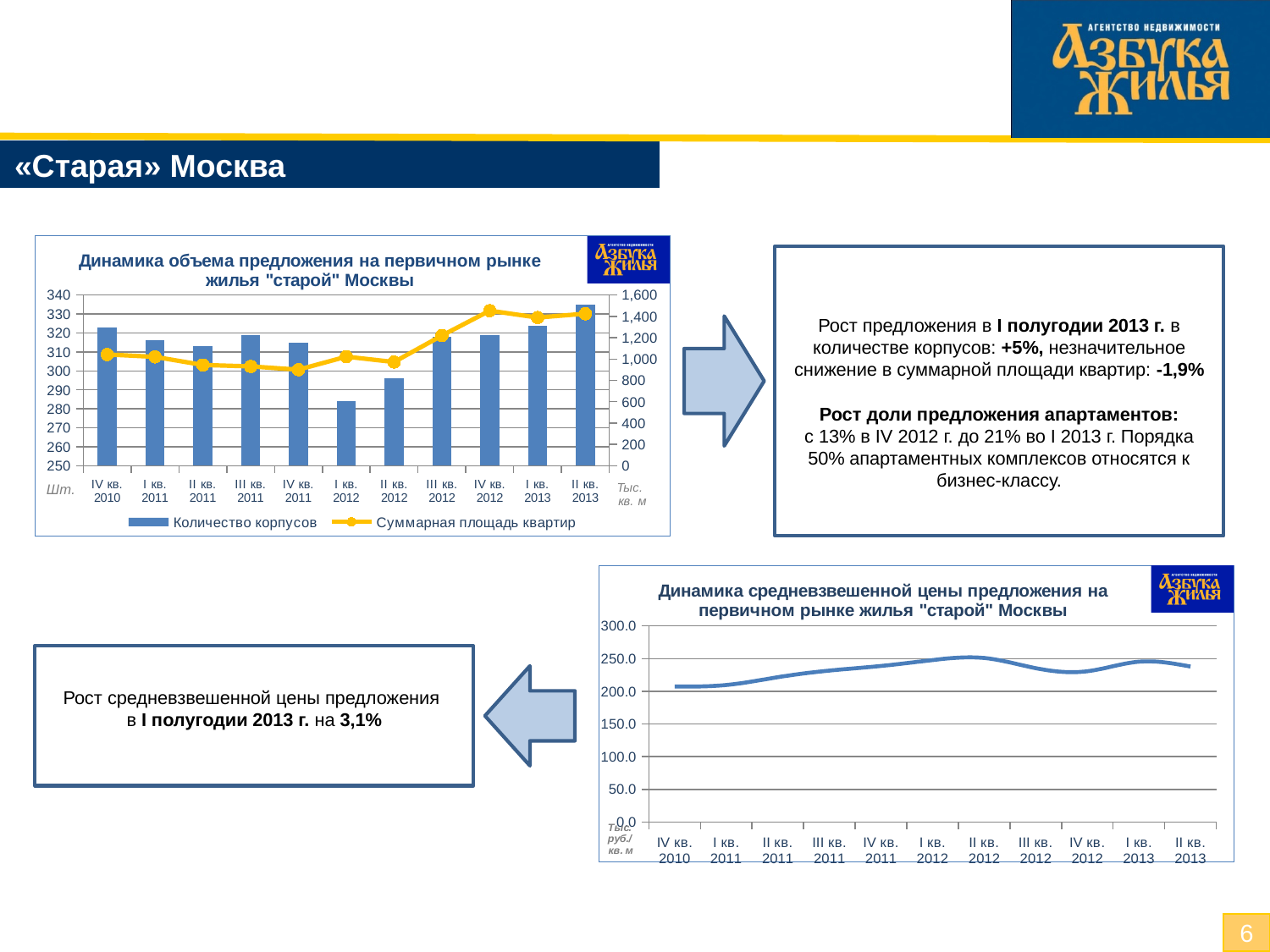
In the bottom-right chart "Динамика средневзвешенной цены предложения на первичном рынке жилья "старой" Москвы", is the value for IV кв. 2010 greater or less than 250.0? less In the bottom-right chart "Динамика средневзвешенной цены предложения на первичном рынке жилья "старой" Москвы", does the value rise or fall from IV кв. 2010 to IV кв. 2012? rise In the bottom-right chart "Динамика средневзвешенной цены предложения на первичном рынке жилья "старой" Москвы", how many quarters are shown on the x axis? 11 In the top-left chart "Динамика объема предложения на первичном рынке жилья "старой" Москвы", which series is drawn as a line with markers? Суммарная площадь квартир In the top-left chart "Динамика объема предложения на первичном рынке жилья "старой" Москвы", which quarter has the highest bar for Количество корпусов? II кв. 2013 In the top-left chart "Динамика объема предложения на первичном рынке жилья "старой" Москвы", is the Количество корпусов value for I кв. 2012 greater or less than 290? less In the top-left chart "Динамика объема предложения на первичном рынке жилья "старой" Москвы", how many quarters are shown on the x axis? 11 In the top-left chart "Динамика объема предложения на первичном рынке жилья "старой" Москвы", how many series does the legend list? 2 In the bottom-right chart "Динамика средневзвешенной цены предложения на первичном рынке жилья "старой" Москвы", which quarter has the highest value? II кв. 2012 What kind of chart is the bottom-right chart "Динамика средневзвешенной цены предложения на первичном рынке жилья "старой" Москвы"? line chart In the top-left chart "Динамика объема предложения на первичном рынке жилья "старой" Москвы", is the Суммарная площадь квартир value for I кв. 2012 greater or less than 1,200? less In the top-left chart "Динамика объема предложения на первичном рынке жилья "старой" Москвы", which quarter has the lowest bar for Количество корпусов? I кв. 2012